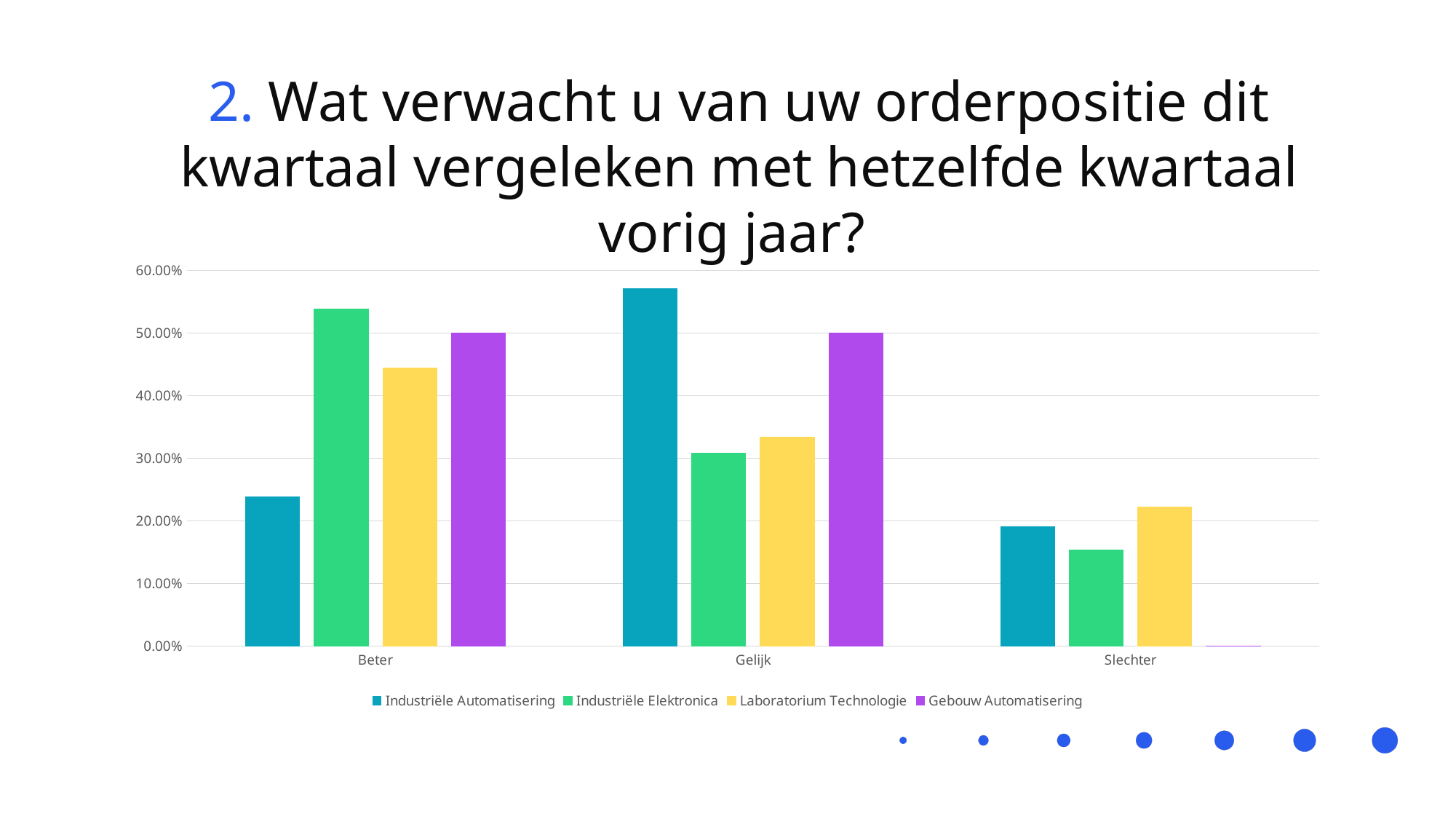
Which series has the highest value in the Gelijk category? Industriële Automatisering Is the value for Industriële Elektronica in the Beter category greater or less than 50.00%? greater Which series has the lowest value in the Slechter category? Gebouw Automatisering Is the value for Industriële Automatisering in the Beter category greater or less than 30.00%? less How many categories are shown on the x axis? 3 What colour are the bars for Laboratorium Technologie? yellow Is the value for Laboratorium Technologie in the Slechter category greater or less than 20.00%? greater How many series does the legend list? 4 Which series has the lowest value in the Beter category? Industriële Automatisering Which is larger in the Slechter category: Industriële Automatisering or Industriële Elektronica? Industriële Automatisering What kind of chart is shown on the slide? bar chart Which is larger in the Gelijk category: Industriële Elektronica or Gebouw Automatisering? Gebouw Automatisering